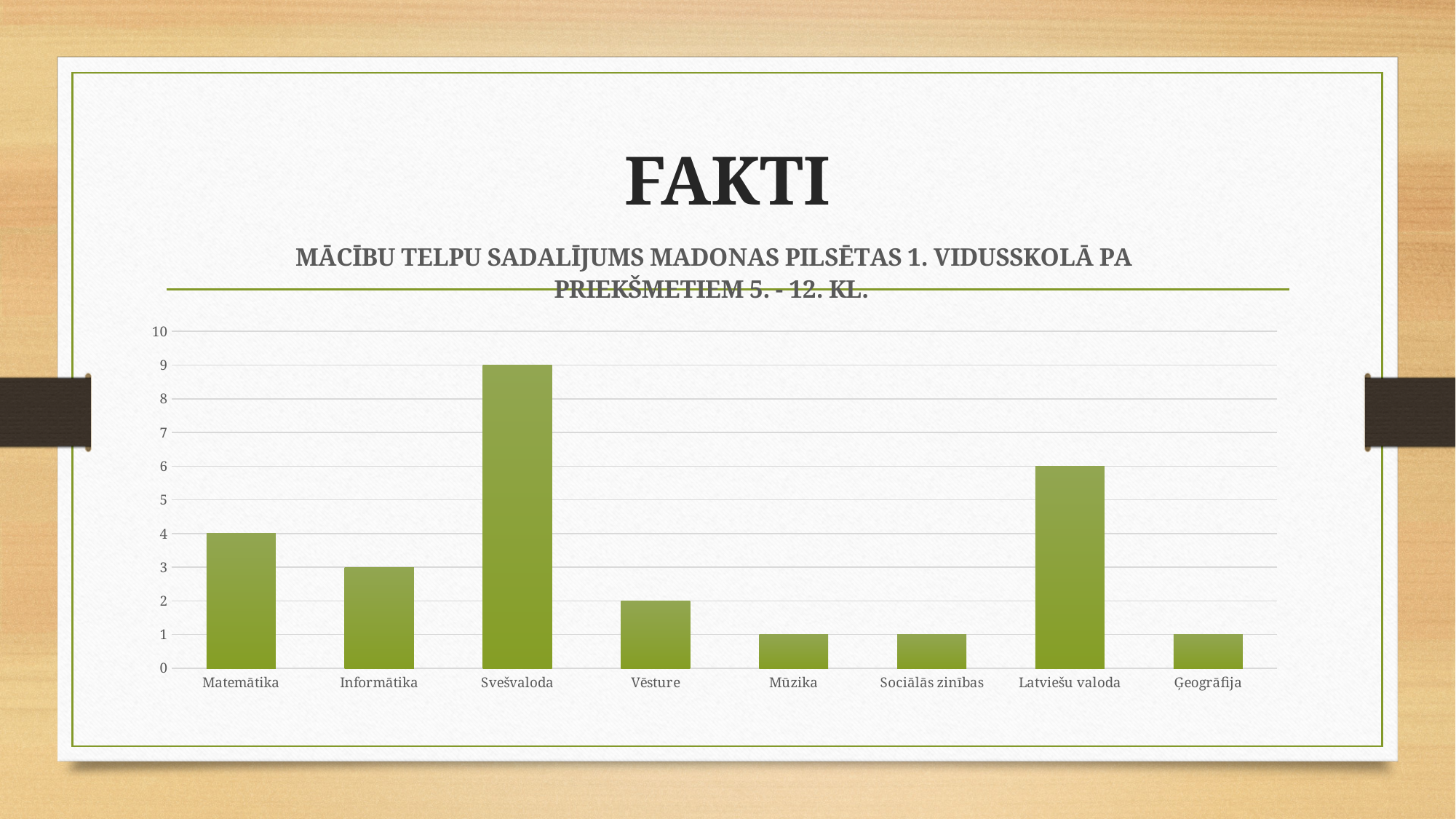
How many subjects have a value of 1? 3 What is the value for Latviešu valoda? 6 What is the value for Svešvaloda? 9 Is the value for Latviešu valoda greater or less than 5? greater What is the title of the chart? MĀCĪBU TELPU SADALĪJUMS MADONAS PILSĒTAS 1. VIDUSSKOLĀ PA PRIEKŠMETIEM 5. - 12. KL. Which is larger, the value for Matemātika or the value for Vēsture? Matemātika Which subject has the highest value? Svešvaloda How many subjects (categories) are shown on the x axis? 8 What type of chart is shown on the slide? bar chart What is the value for Informātika? 3 What is the value for Matemātika? 4 What is the difference between the values for Svešvaloda and Latviešu valoda? 3